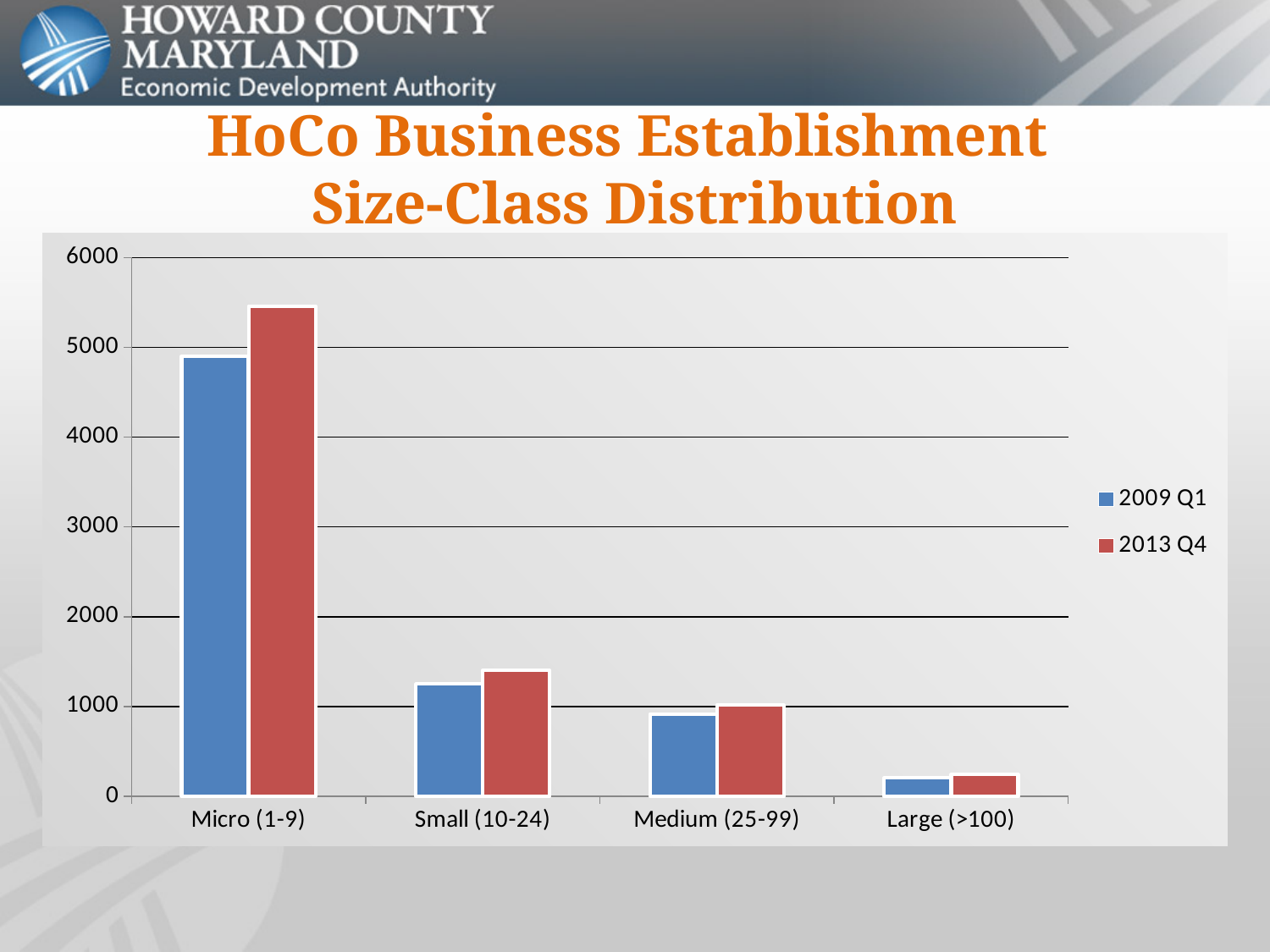
Is the 2013 Q4 value for Micro (1-9) greater or less than 5000? greater How many size-class categories are shown on the x axis? 4 Is the 2009 Q1 value for Small (10-24) greater or less than 1000? greater For Micro (1-9), which is larger: the 2009 Q1 value or the 2013 Q4 value? 2013 Q4 Which size class has the highest value for 2013 Q4? Micro (1-9) What kind of chart is shown on the slide? bar chart Is the 2009 Q1 value for Micro (1-9) greater or less than 5000? less Do the values fall or rise moving from Micro (1-9) to Large (>100) along the x axis? fall What are the two series named in the legend? 2009 Q1 and 2013 Q4 Which size class has the lowest value for 2009 Q1? Large (>100) How many series does the legend list? 2